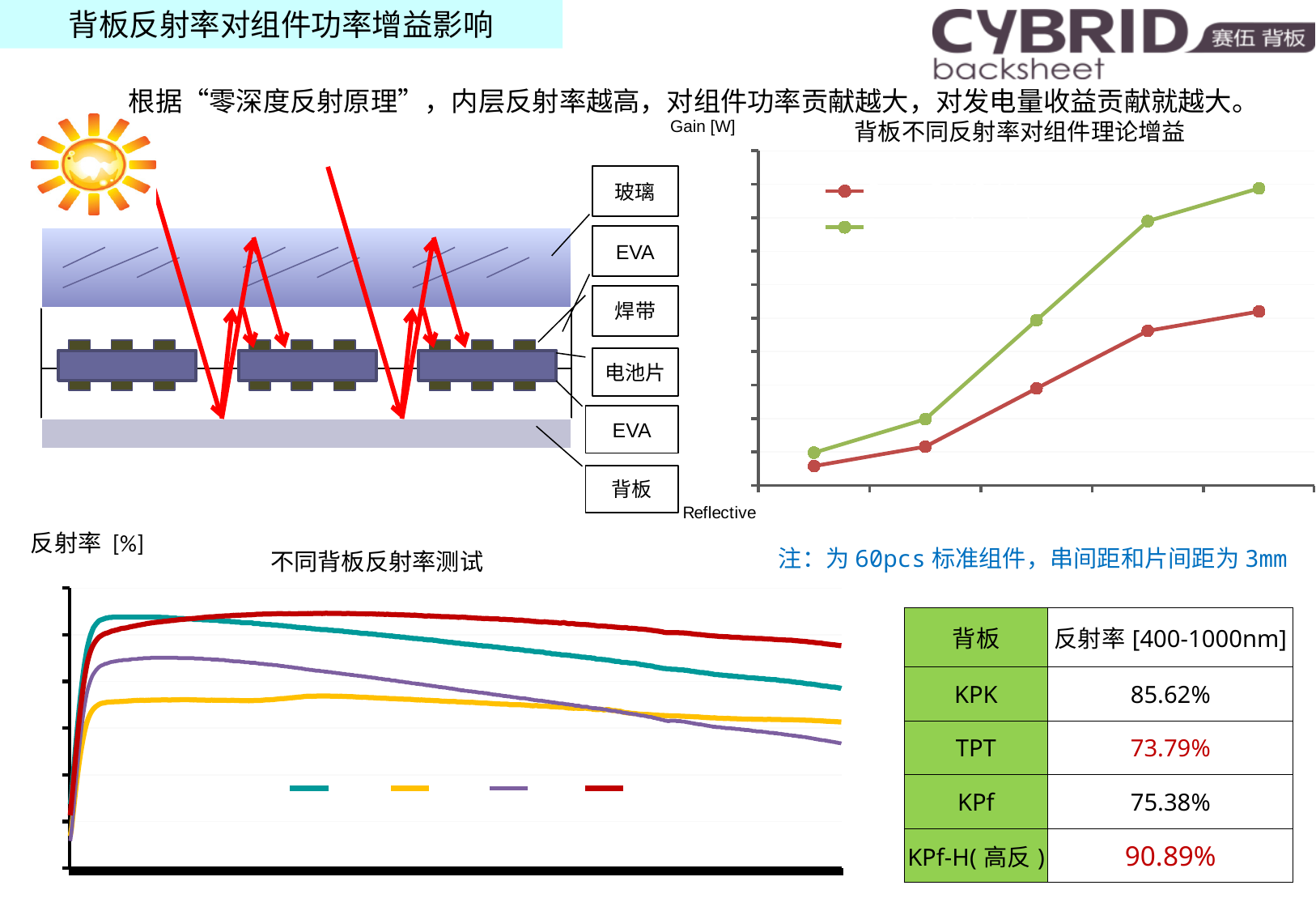
In the top-right chart 背板不同反射率对组件理论增益, do the values of the red line rise or fall from left to right? rise In the bottom-left chart 不同背板反射率测试, does the teal line rise or fall across the right half of the x axis? fall What is the title of the bottom-left line chart? 不同背板反射率测试 What kind of chart is the top-right chart titled 背板不同反射率对组件理论增益? line chart In the bottom-left chart 不同背板反射率测试, how many series does the legend list? 4 In the bottom-left chart 不同背板反射率测试, which line is lowest at the right end of the x axis? purple line What is the title of the top-right line chart? 背板不同反射率对组件理论增益 In the top-right chart 背板不同反射率对组件理论增益, which line is higher at the rightmost point, the green line or the red line? green line In the bottom-left chart 不同背板反射率测试, which line is highest at the right end of the x axis? red line In the top-right chart 背板不同反射率对组件理论增益, how many series does the legend list? 2 In the top-right chart 背板不同反射率对组件理论增益, how many data points does the green line have? 5 What kind of chart is the bottom-left chart titled 不同背板反射率测试? line chart